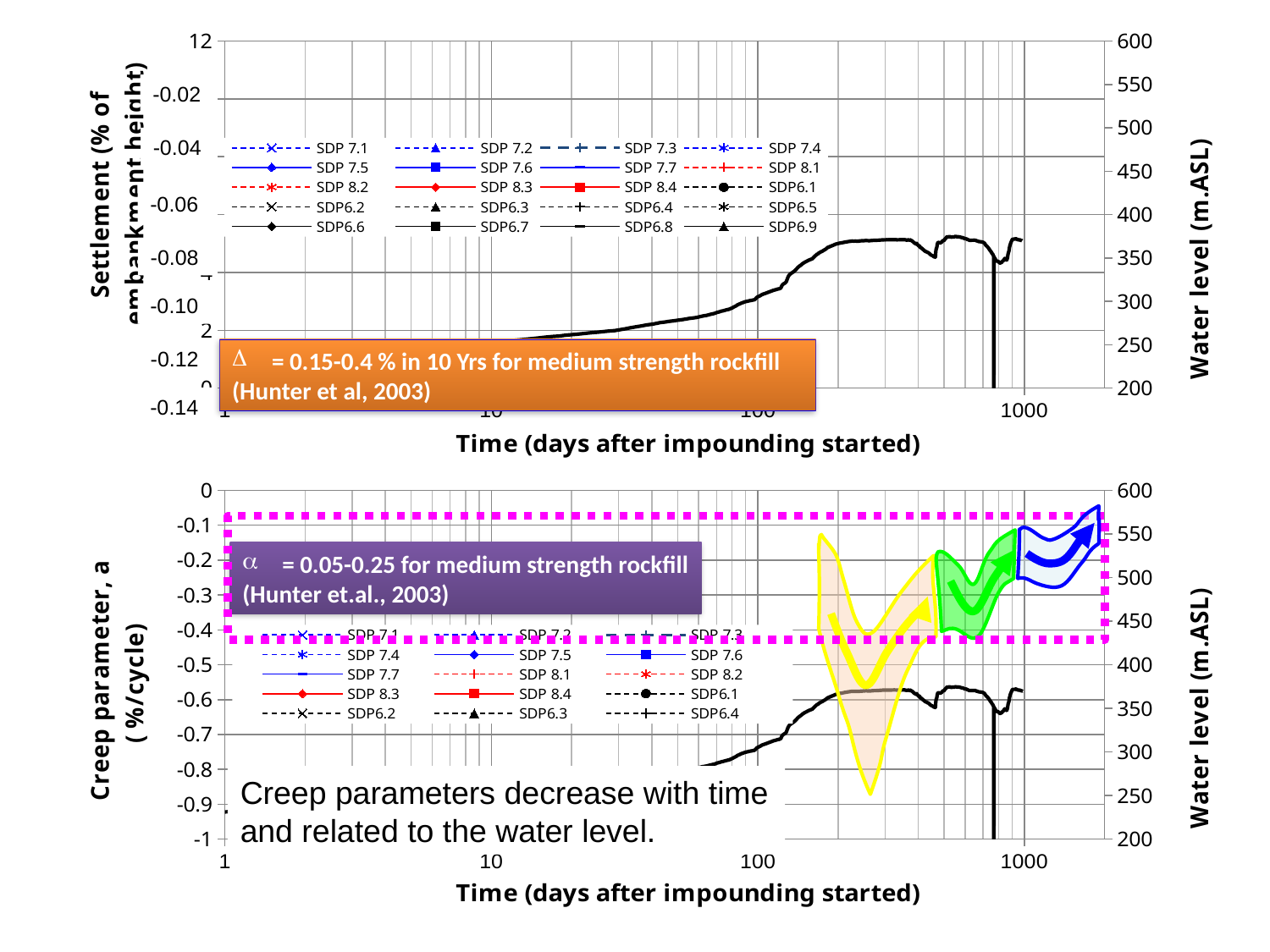
What kind of chart is the bottom chart (Creep parameter vs Time)? line chart What kind of chart is the top chart (Settlement vs Time)? line chart In the bottom chart, how many series does the legend list? 15 In the top chart, does the water level line rise or fall as time increases from 100 to 1000 days? rise In the bottom chart, does the water level line rise or fall as time increases from 100 to 1000 days? rise In the bottom chart, is the water level at 1000 days greater or less than 300? greater In the bottom chart, what is the label of the right-hand vertical axis? Water level (m.ASL) In the top chart, how many series does the legend list? 20 In the bottom chart, is the water level at 1000 days greater or less than 500? less In the top chart, is the water level at 100 days greater or less than 400? less In the top chart, what is the title of the x axis? Time (days after impounding started)